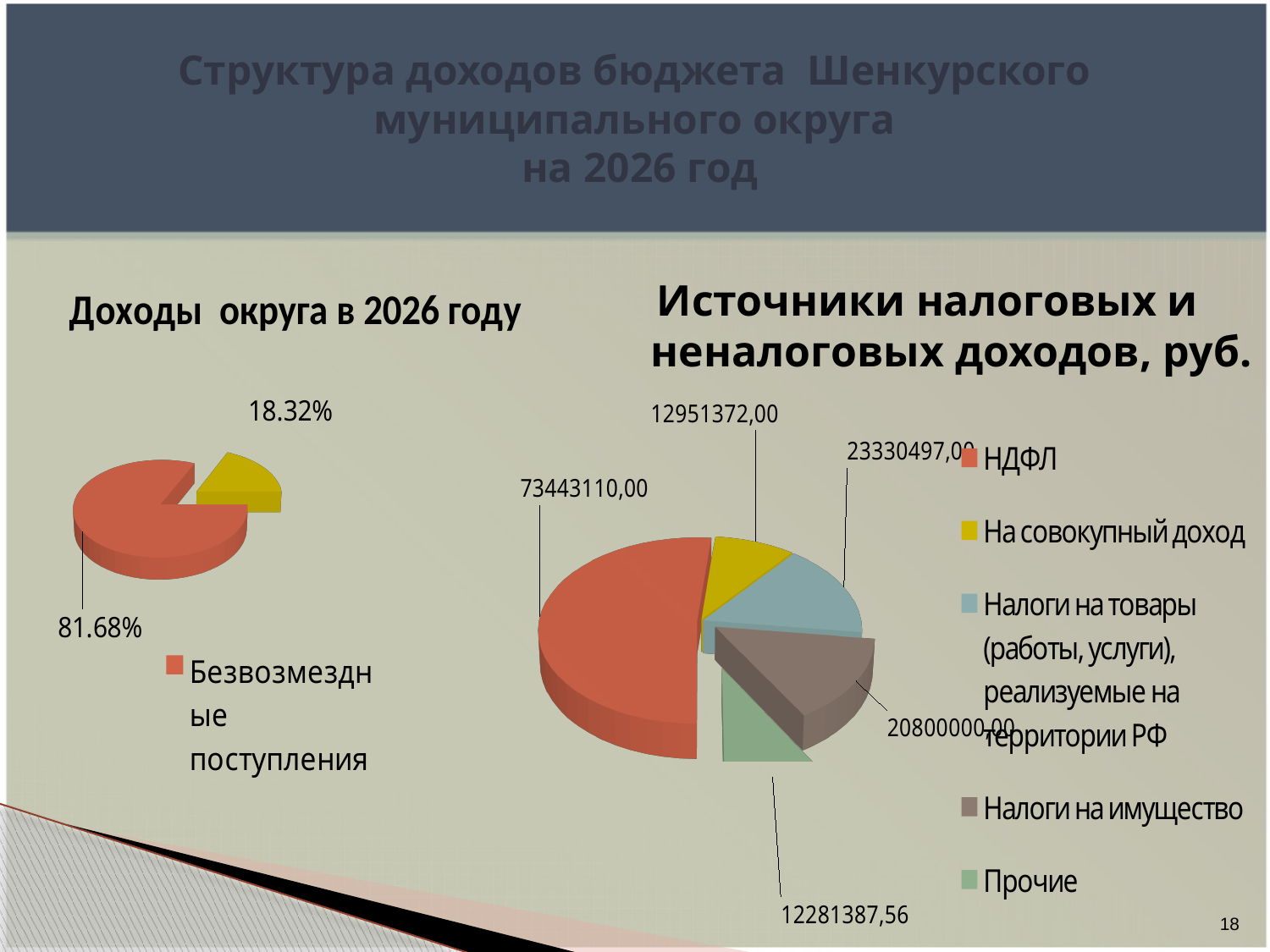
On the chart titled 'Источники налоговых и неналоговых доходов, руб.', which category has the largest value? НДФЛ On the chart titled 'Источники налоговых и неналоговых доходов, руб.', what is the value for Прочие? 12281387,56 On the chart titled 'Доходы округа в 2026 году', what share is shown for Безвозмездные поступления? 81.68% On the chart titled 'Источники налоговых и неналоговых доходов, руб.', what is the value for Налоги на имущество? 20800000,00 On the chart titled 'Источники налоговых и неналоговых доходов, руб.', what is the value for НДФЛ? 73443110,00 On the chart titled 'Источники налоговых и неналоговых доходов, руб.', how many entries does the legend list? 5 On the chart titled 'Источники налоговых и неналоговых доходов, руб.', which is larger: Налоги на товары (работы, услуги), реализуемые на территории РФ or Налоги на имущество? Налоги на товары (работы, услуги), реализуемые на территории РФ On the chart titled 'Источники налоговых и неналоговых доходов, руб.', which category has the smallest value? Прочие On the chart titled 'Источники налоговых и неналоговых доходов, руб.', how many slices does the pie have? 5 What kind of chart is the one titled 'Источники налоговых и неналоговых доходов, руб.'? Pie chart On the chart titled 'Источники налоговых и неналоговых доходов, руб.', what is the difference between the values for НДФЛ and Налоги на имущество? 52643110,00 On the chart titled 'Доходы округа в 2026 году', how many slices does the pie have? 2